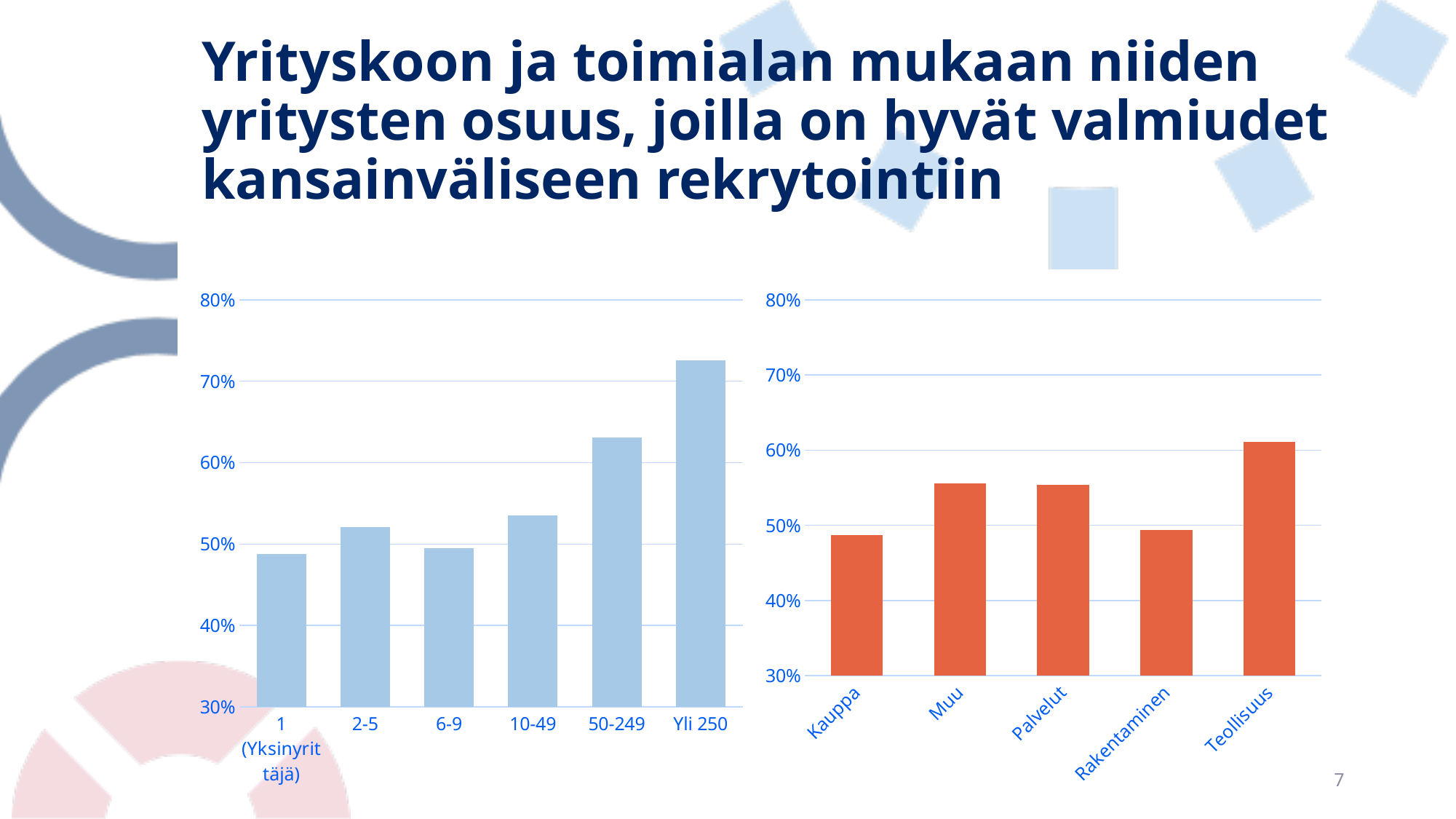
How many categories are shown on the left chart (by company size)? 6 On the right chart (by industry), which is larger, the value for Teollisuus or the value for Kauppa? Teollisuus On the right chart (by industry), is the value for Kauppa greater or less than 50%? less On the right chart (by industry), which category has the highest value? Teollisuus What kind of chart is the right chart (by industry)? bar chart On the left chart (by company size), is the value for Yli 250 greater or less than 70%? greater On the right chart (by industry), is the value for Teollisuus greater or less than 60%? greater On the left chart (by company size), which category has the highest value? Yli 250 How many categories are shown on the right chart (by industry)? 5 On the left chart (by company size), which is larger, the value for Yli 250 or the value for 50-249? Yli 250